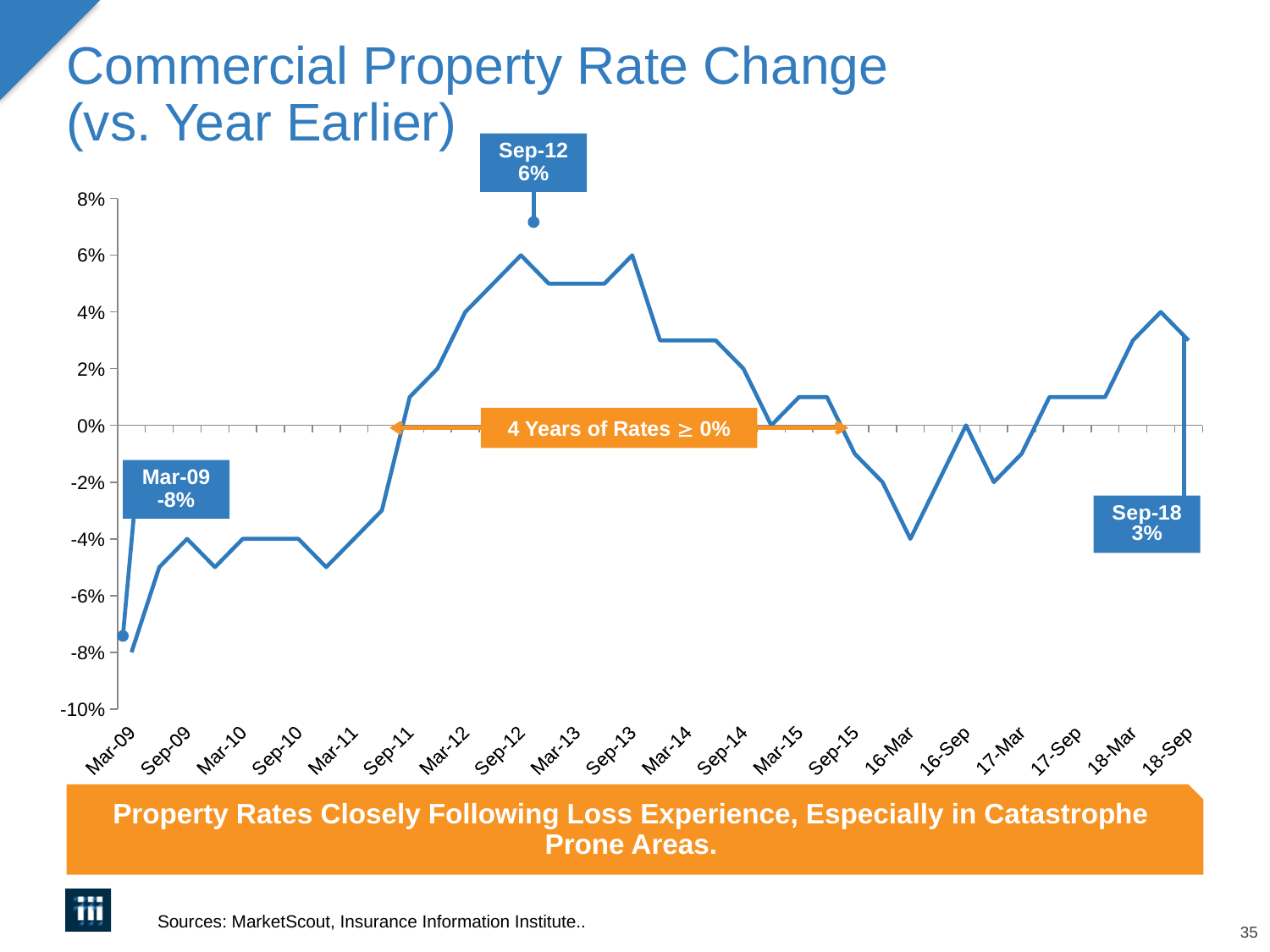
Which is larger, the rate change in Sep-12 or in Sep-18? Sep-12 Does the rate change rise or fall from Mar-09 to Sep-12? Rise Which labeled point has the lowest rate change on the chart? Mar-09 What is the commercial property rate change for Mar-09? -8% What type of chart is shown on the slide? Line chart What does the orange annotation in the middle of the chart say? 4 Years of Rates ≥ 0% What is the commercial property rate change for Sep-12? 6% What is the difference between the rate change in Sep-12 and in Sep-18? 3 percentage points Is the value for Sep-13 greater or less than 4%? greater What is the commercial property rate change for Sep-18? 3% What is the difference between the rate change in Sep-12 and in Mar-09? 14 percentage points Is the value for Mar-11 greater or less than -2%? less